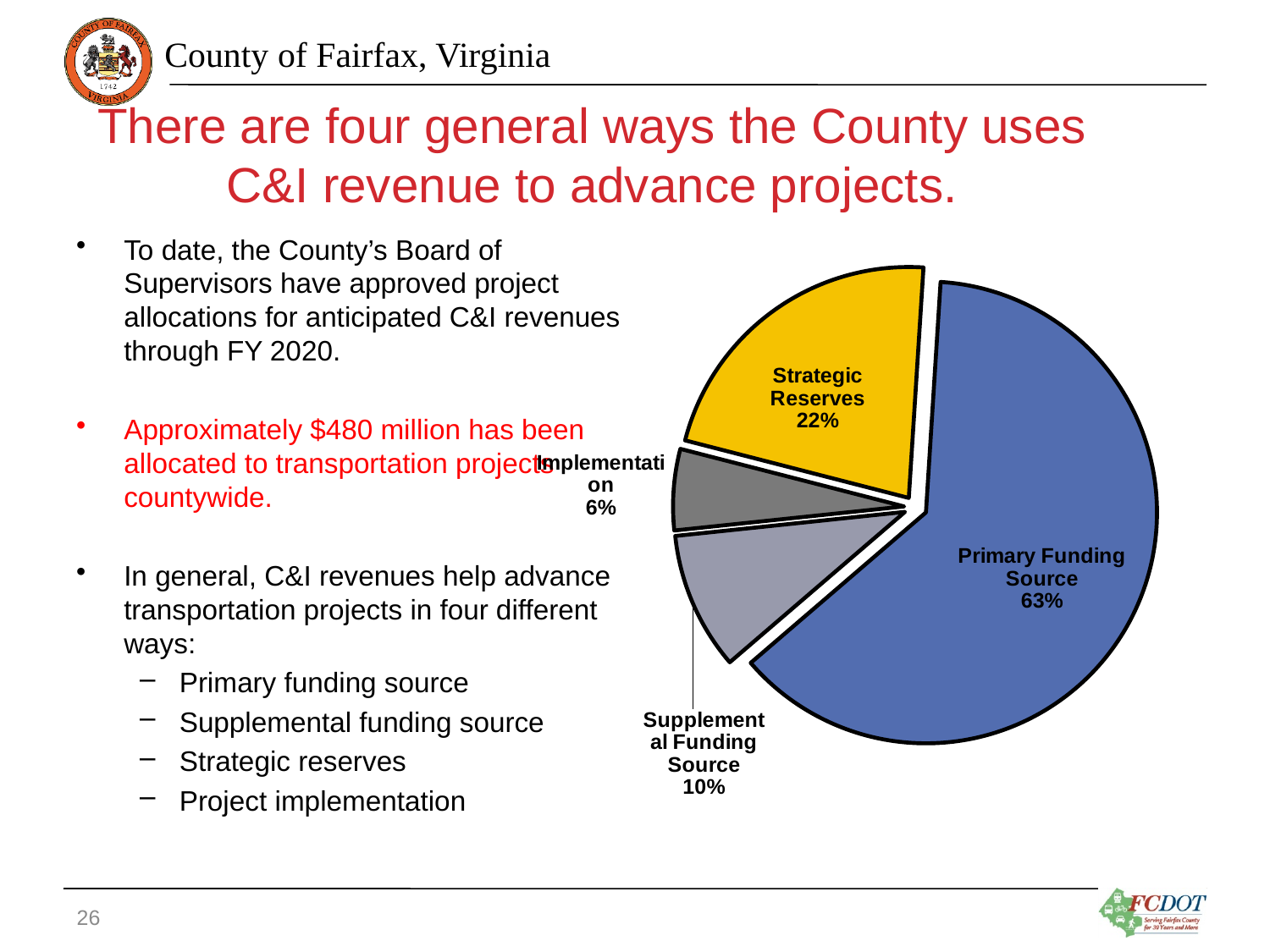
What share of the pie is Primary Funding Source? 63% What is the difference in percentage points between Primary Funding Source and Strategic Reserves? 41 What share of the pie is Supplemental Funding Source? 10% What colour is the Strategic Reserves slice of the pie chart? Yellow Which slice of the pie chart is the smallest? Implementation What share of the pie is Implementation? 6% What is the difference in percentage points between Strategic Reserves and Supplemental Funding Source? 12 Which is larger, Supplemental Funding Source or Implementation? Supplemental Funding Source How many slices does the pie chart have? 4 What kind of chart is shown on the slide? Pie chart Which slice of the pie chart is the largest? Primary Funding Source